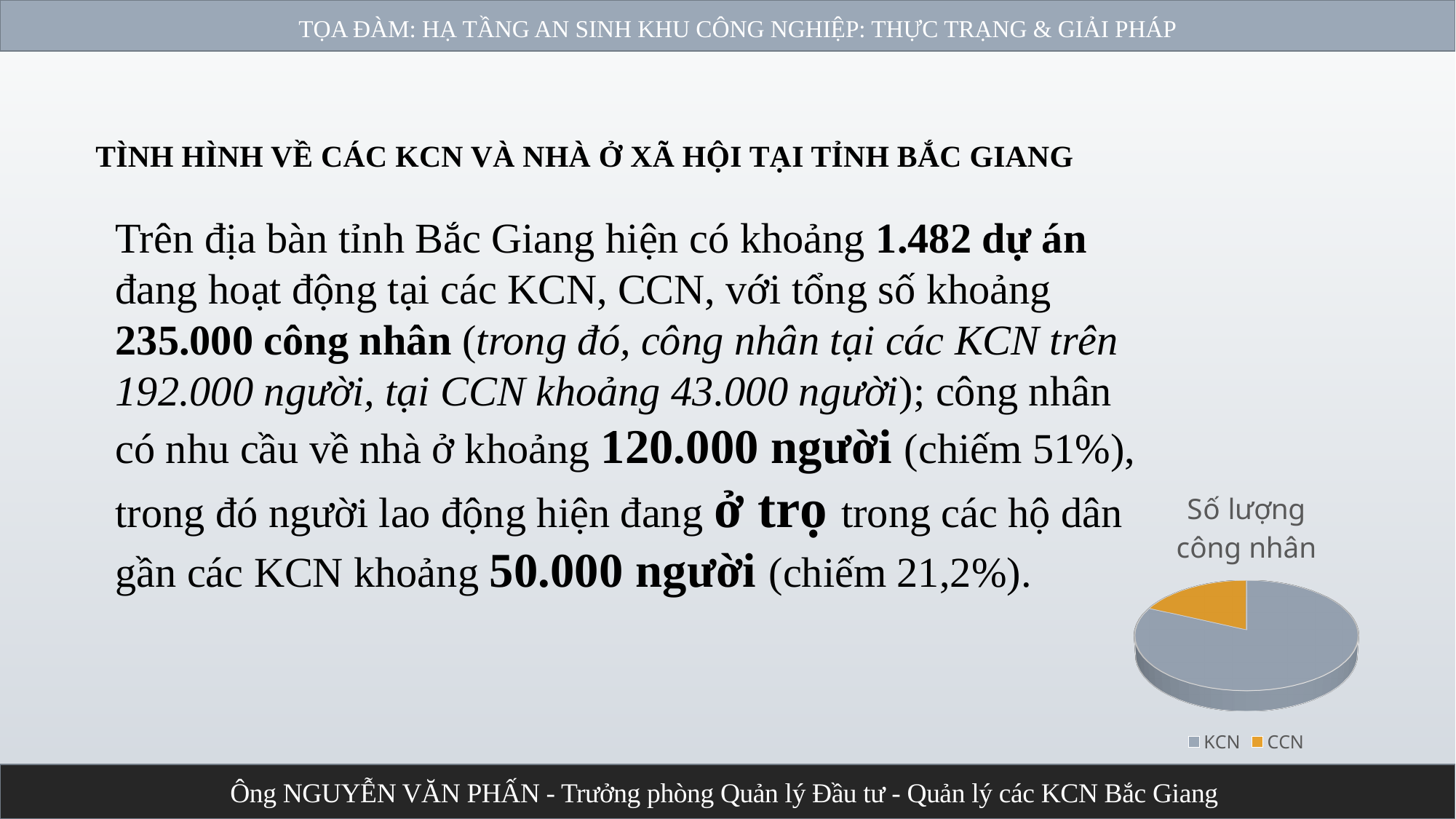
Which category has the smallest slice in the pie chart? CCN What colour is the CCN slice in the pie chart? orange What is the title of the pie chart? Số lượng công nhân What kind of chart is shown on the slide? pie chart Is the KCN slice more or less than half of the pie chart? more Which category has the largest slice in the pie chart? KCN In the pie chart, which slice is larger, KCN or CCN? KCN How many slices does the pie chart have? 2 How many entries does the legend of the pie chart list? 2